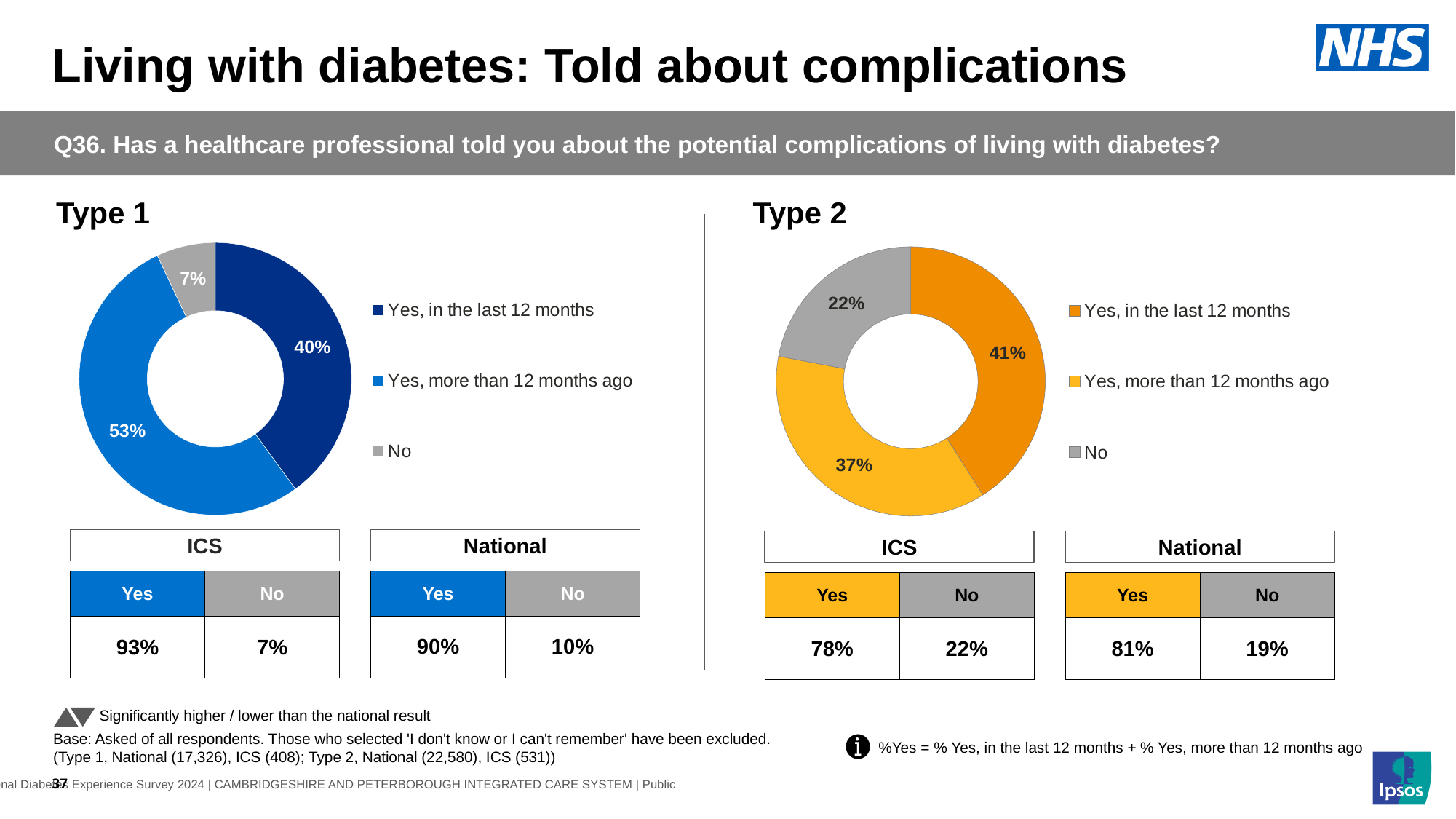
In the Type 2 chart, what percentage of respondents said 'No'? 22% In the Type 1 chart, what is the combined share of the two 'Yes' categories? 93% In the Type 2 chart, which category has the smallest share? No In the Type 1 chart, what percentage of respondents said 'Yes, more than 12 months ago'? 53% How many categories does the Type 2 chart's legend list? 3 What kind of chart is used for Type 1? Doughnut chart In the Type 2 chart, which is larger: 'Yes, in the last 12 months' or 'Yes, more than 12 months ago'? Yes, in the last 12 months In the Type 1 chart, what is the difference between the 'Yes, more than 12 months ago' share and the 'Yes, in the last 12 months' share? 13 percentage points What colour represents 'No' in both the Type 1 and Type 2 charts? Grey In the Type 2 chart, what percentage of respondents said 'Yes, more than 12 months ago'? 37% In the Type 1 chart, what percentage of respondents said 'Yes, in the last 12 months'? 40% In the Type 1 chart, which category has the largest share? Yes, more than 12 months ago